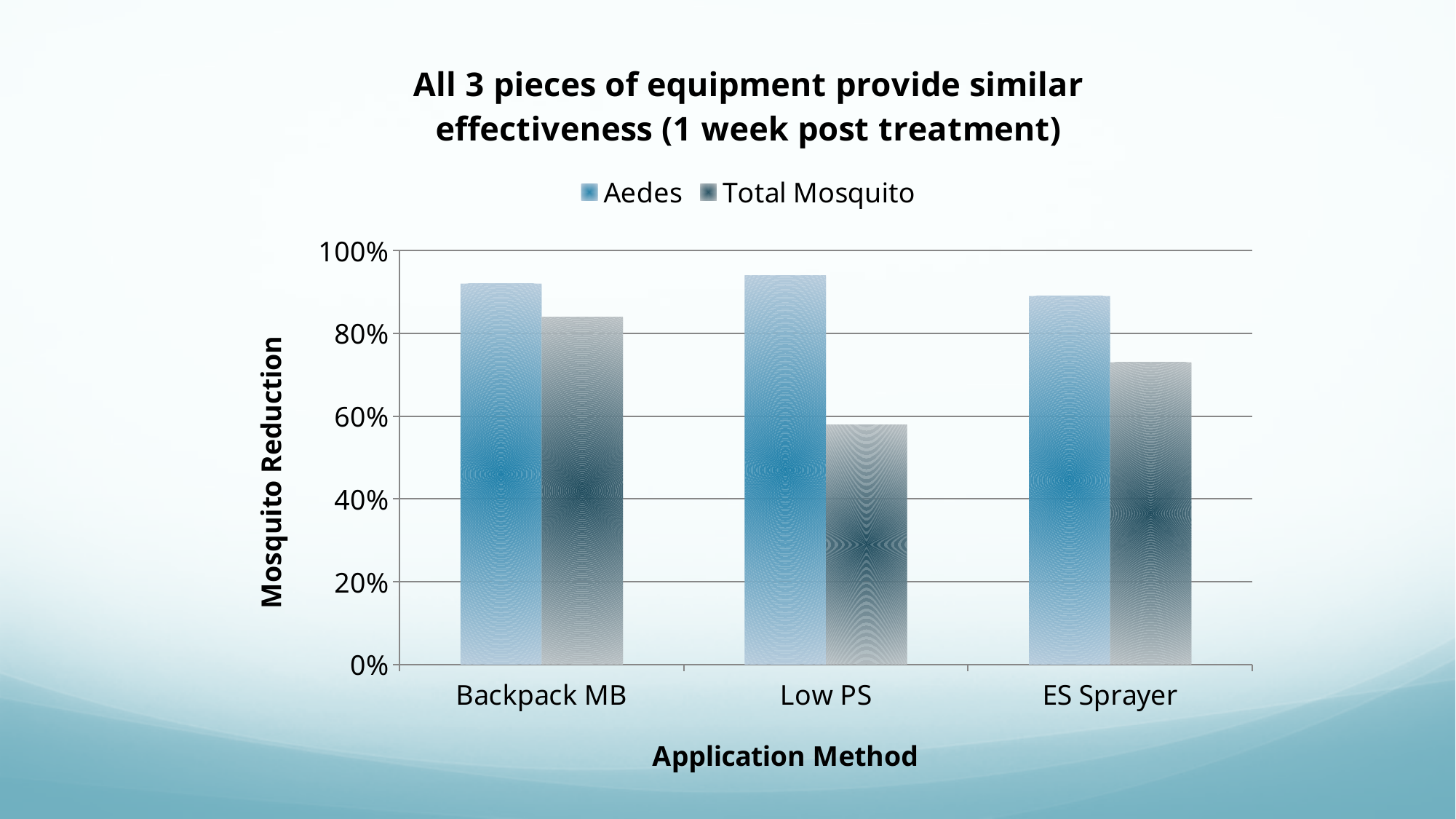
Is the Aedes reduction for ES Sprayer greater or less than 80%? greater Which application method has the lowest Aedes reduction? ES Sprayer Is the Total Mosquito reduction for Backpack MB greater or less than 80%? greater Is the Total Mosquito reduction for ES Sprayer greater or less than 80%? less For Low PS, which is larger: the Aedes reduction or the Total Mosquito reduction? Aedes Which application method has the highest Total Mosquito reduction? Backpack MB How many application methods are shown on the x axis? 3 What kind of chart is shown on the slide? bar chart Which application method has the lowest Total Mosquito reduction? Low PS What is the label of the y axis? Mosquito Reduction How many series does the legend list? 2